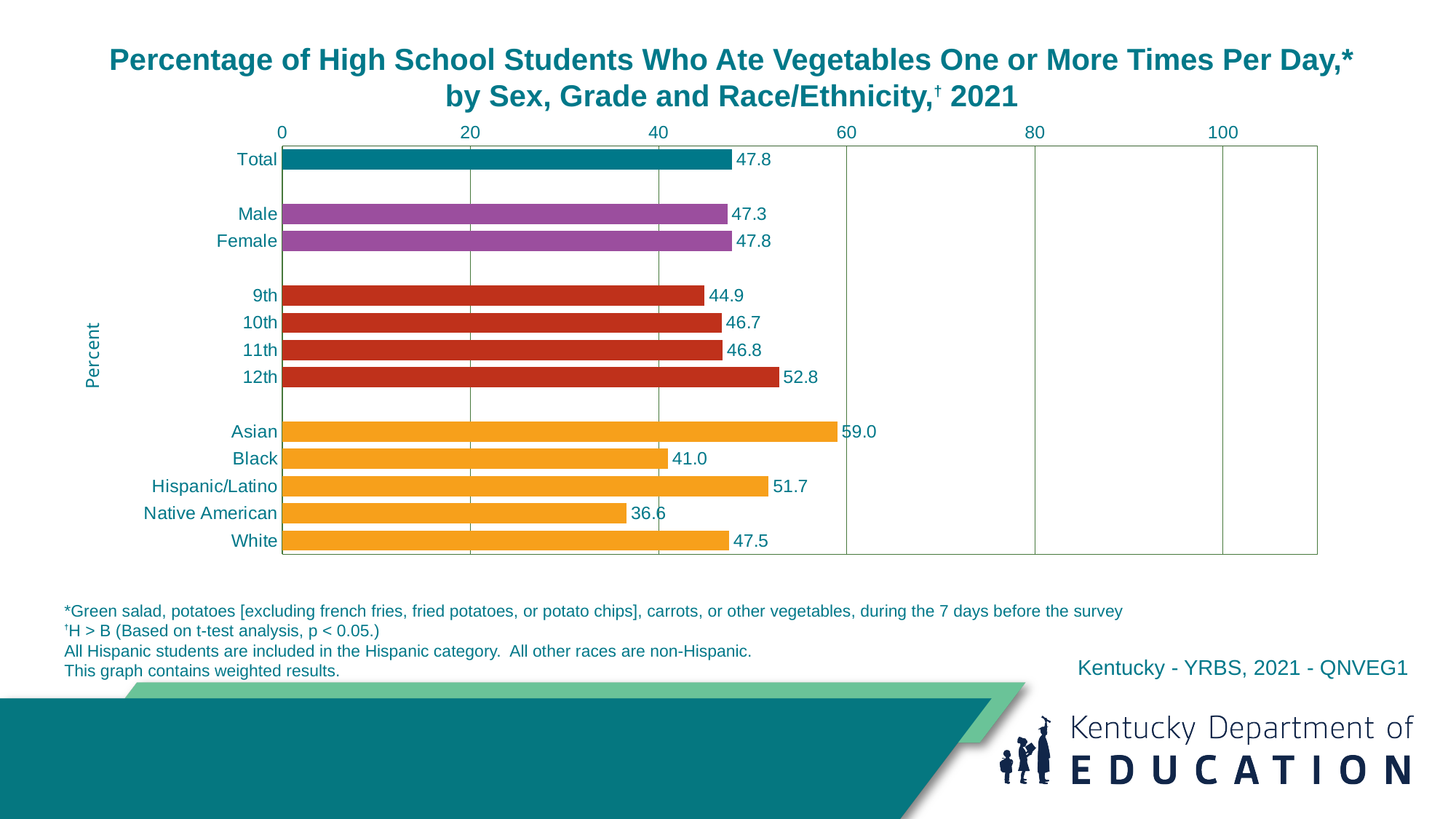
What is the value for 12th grade? 52.8 Is the value for Asian students greater or less than 40? greater Which is larger, the value for 12th grade or the value for 10th grade? 12th What is the value for Native American students? 36.6 Which category has the highest value? Asian What is the difference between the values for 12th and 9th grade? 7.9 What is the value for Hispanic/Latino students? 51.7 Which category has the lowest value? Native American What is the difference between the values for Asian and Black students? 18.0 What kind of chart is shown on the slide? bar chart What is the value for Total? 47.8 How many categories are plotted in the chart? 12